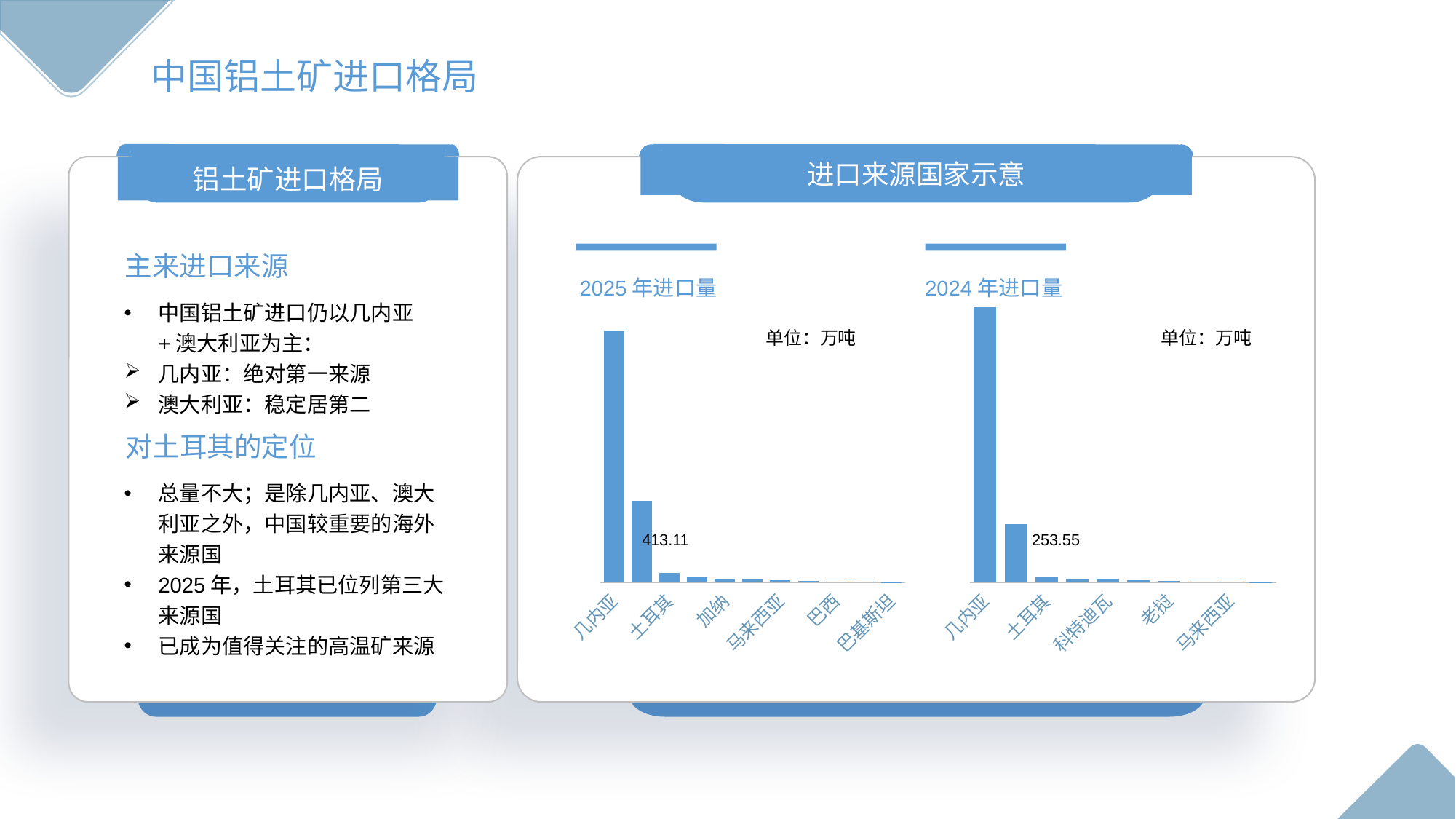
How much larger is the labelled value for 土耳其 in the 2025 年进口量 chart than in the 2024 年进口量 chart? 159.56 In the 2025 年进口量 chart, which is larger, the value for 几内亚 or the value for 土耳其? 几内亚 In the 2024 年进口量 chart, which is larger, the value for 土耳其 or the value for 科特迪瓦? 土耳其 In the 2024 年进口量 chart, what is the value for 土耳其? 253.55 What unit is shown for the values in the 2024 年进口量 chart? 万吨 In the 2024 年进口量 chart, which is larger, the value for 几内亚 or the value for 老挝? 几内亚 In the 2025 年进口量 chart, what is the value for 土耳其? 413.11 What is the title of the panel containing the two charts? 进口来源国家示意 What kind of chart is the 2025 年进口量 chart? Bar chart In the 2025 年进口量 chart, which country has the highest import volume? 几内亚 In the 2025 年进口量 chart, do the values rise or fall moving from left to right along the x axis? Fall In the 2024 年进口量 chart, which country has the highest import volume? 几内亚